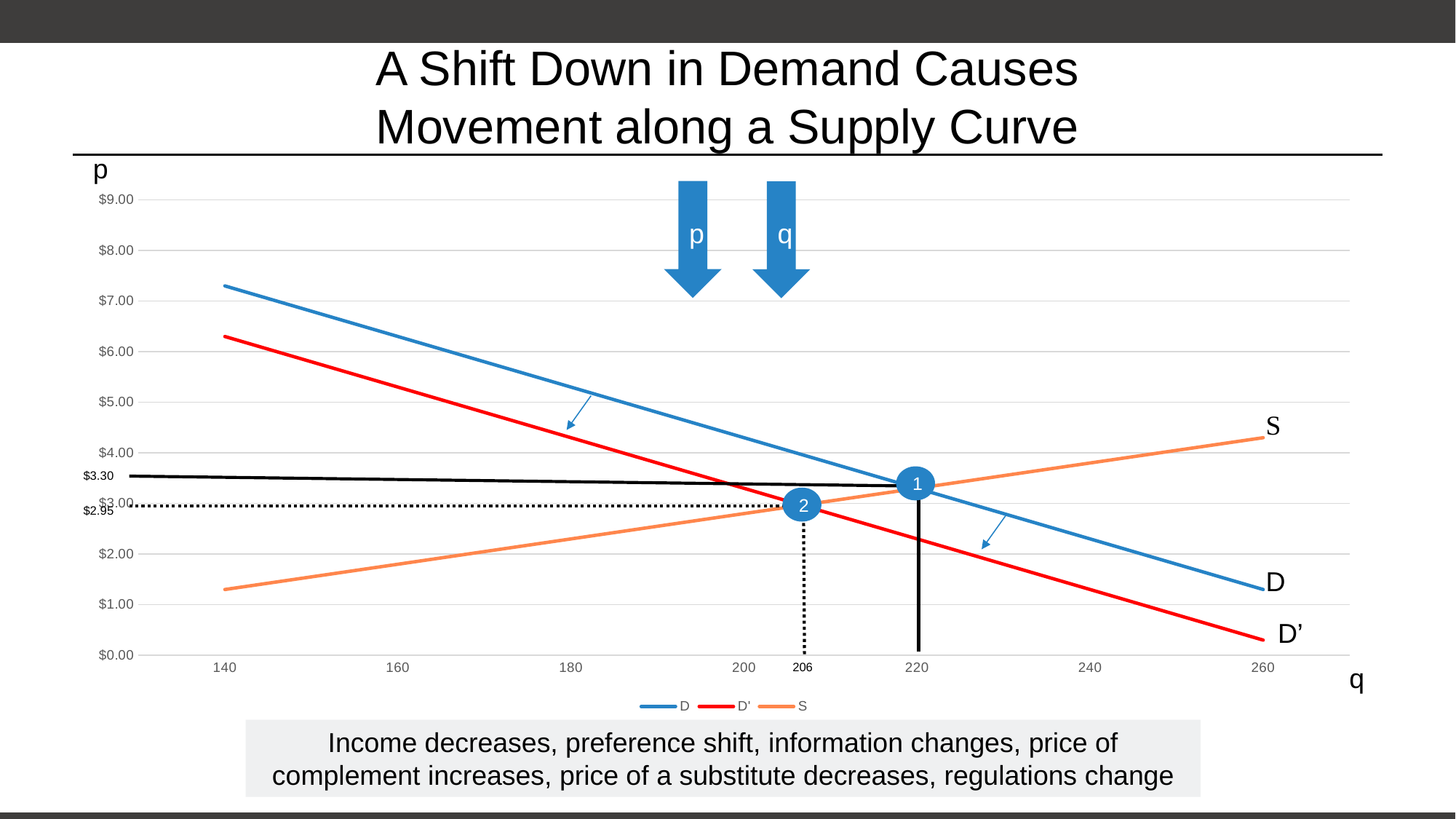
What is the quantity at equilibrium point 1? 220 Does the S line rise or fall as q increases along the x axis? rise What are the three series named in the legend? D, D', S Is the value of the S line at q = 140 greater or less than $2.00? less By how much does the quantity fall from equilibrium point 1 to equilibrium point 2? 14 What is the price at equilibrium point 2? $2.95 How many series does the legend list? 3 By how much does the price fall from equilibrium point 1 to equilibrium point 2? $0.35 At q = 140, which line is higher, D or D'? D What is the price at equilibrium point 1? $3.30 What kind of chart is shown on the slide? line chart What is the quantity at equilibrium point 2? 206